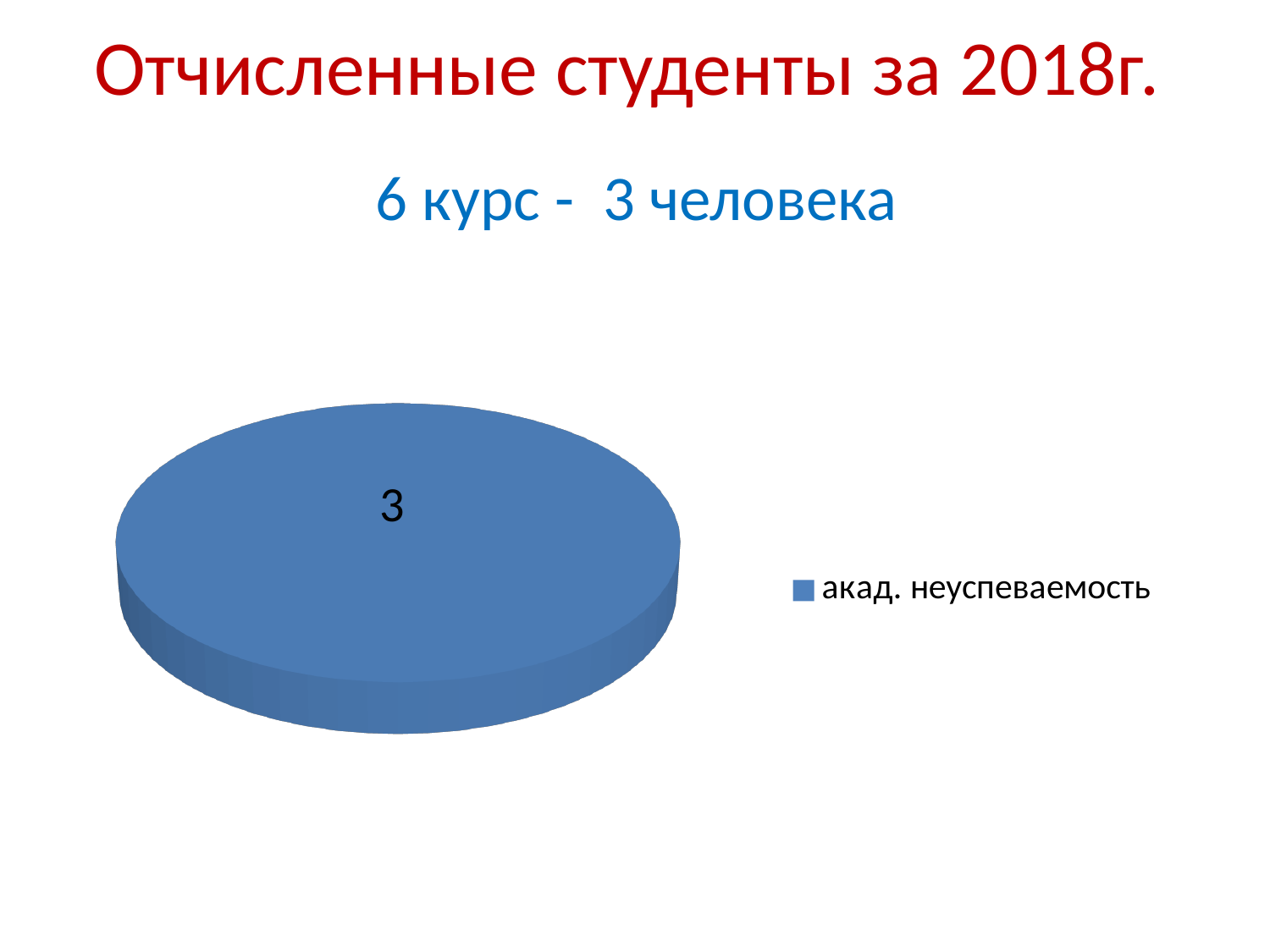
What is the legend entry for the blue slice? акад. неуспеваемость Is the value for акад. неуспеваемость greater or less than 5? less What share of the pie does the акад. неуспеваемость slice take? 100% What is the value shown for акад. неуспеваемость? 3 How many entries does the legend list? 1 How many slices does the pie chart have? 1 What kind of chart is shown on the slide? pie chart What is the title of the slide above the chart? Отчисленные студенты за 2018г.